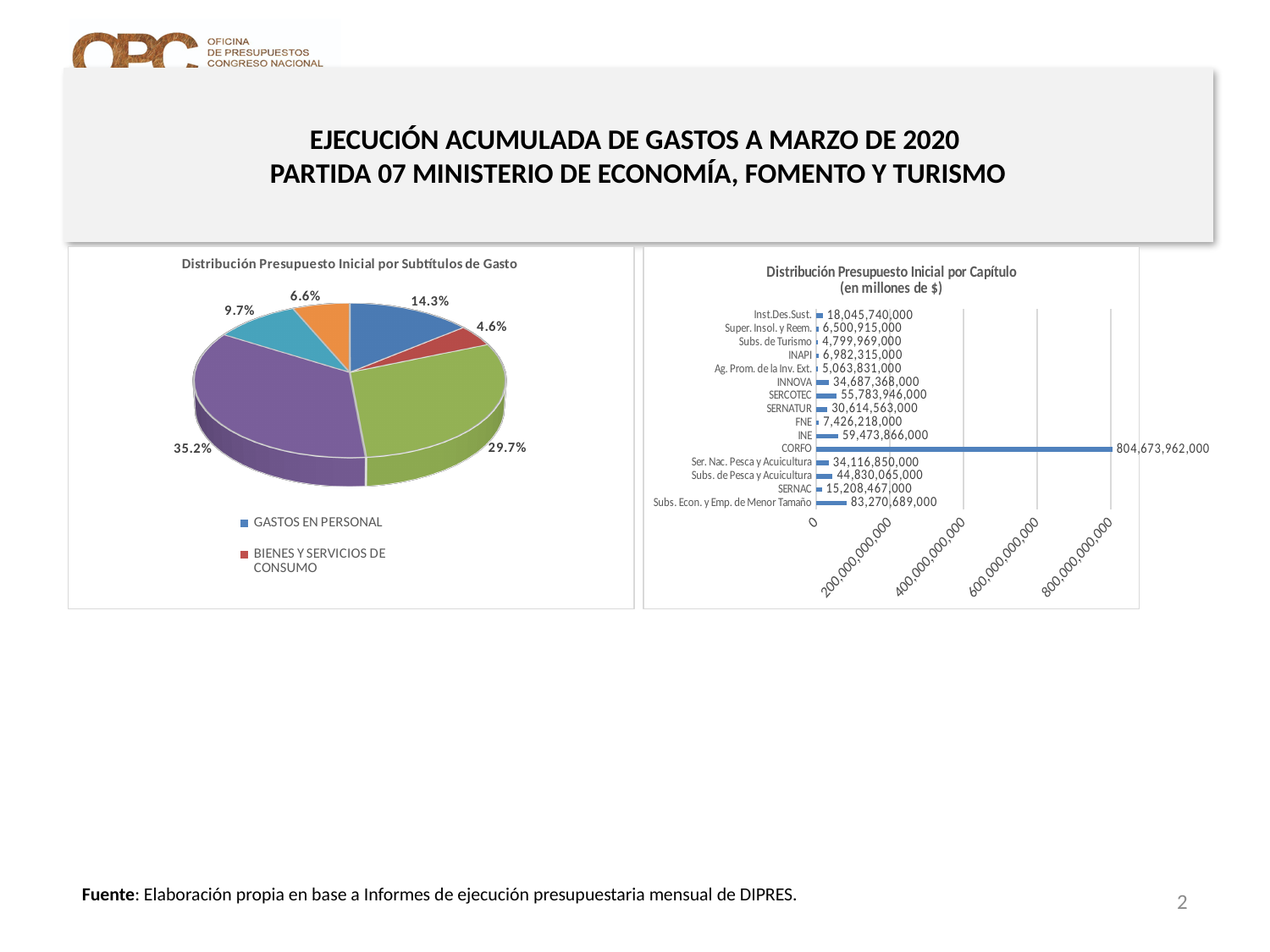
How many capítulos are shown in the chart 'Distribución Presupuesto Inicial por Capítulo'? 15 What kind of chart is the chart on the right, 'Distribución Presupuesto Inicial por Capítulo'? Bar chart In the pie chart on the left, what percentage is shown on the largest slice? 35.2% In the pie chart 'Distribución Presupuesto Inicial por Subtítulos de Gasto', what share does GASTOS EN PERSONAL have? 14.3% In the chart 'Distribución Presupuesto Inicial por Capítulo', what is the difference between the values for INE and SERCOTEC? 3,689,920,000 In the chart 'Distribución Presupuesto Inicial por Capítulo', which is larger, INNOVA or SERNATUR? INNOVA How many entries does the legend of the pie chart on the left list? 2 In the chart 'Distribución Presupuesto Inicial por Capítulo', which capítulo has the lowest value? Subs. de Turismo How many slices does the pie chart 'Distribución Presupuesto Inicial por Subtítulos de Gasto' have? 6 In the chart 'Distribución Presupuesto Inicial por Capítulo', what is the value for CORFO? 804,673,962,000 In the chart 'Distribución Presupuesto Inicial por Capítulo', is the value for CORFO greater or less than 800,000,000,000? greater In the pie chart 'Distribución Presupuesto Inicial por Subtítulos de Gasto', what share does BIENES Y SERVICIOS DE CONSUMO have? 4.6%